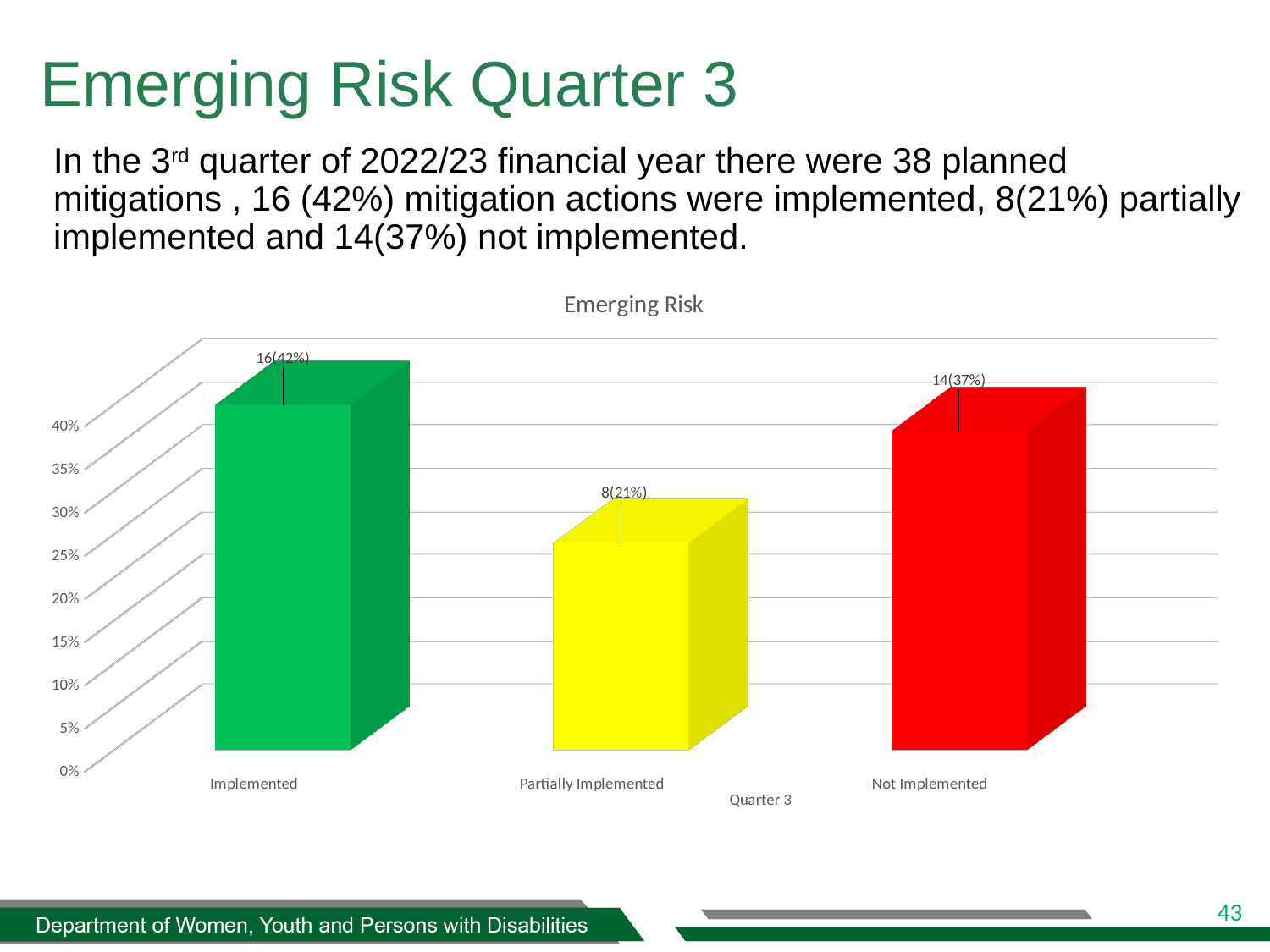
Which category has the lowest value? Partially Implemented What is the data label shown for the Implemented bar? 16(42%) What is the difference in percentage points between Implemented and Not Implemented? 5% Is the value for Partially Implemented greater or less than 25%? less What is the difference in count between Implemented and Partially Implemented? 8 What is the title of the chart? Emerging Risk Which category has the highest value? Implemented What kind of chart is shown on the slide? Bar chart What is the data label shown for the Not Implemented bar? 14(37%) What is the data label shown for the Partially Implemented bar? 8(21%) Which is larger, the value for Not Implemented or the value for Partially Implemented? Not Implemented How many categories are shown on the chart? 3